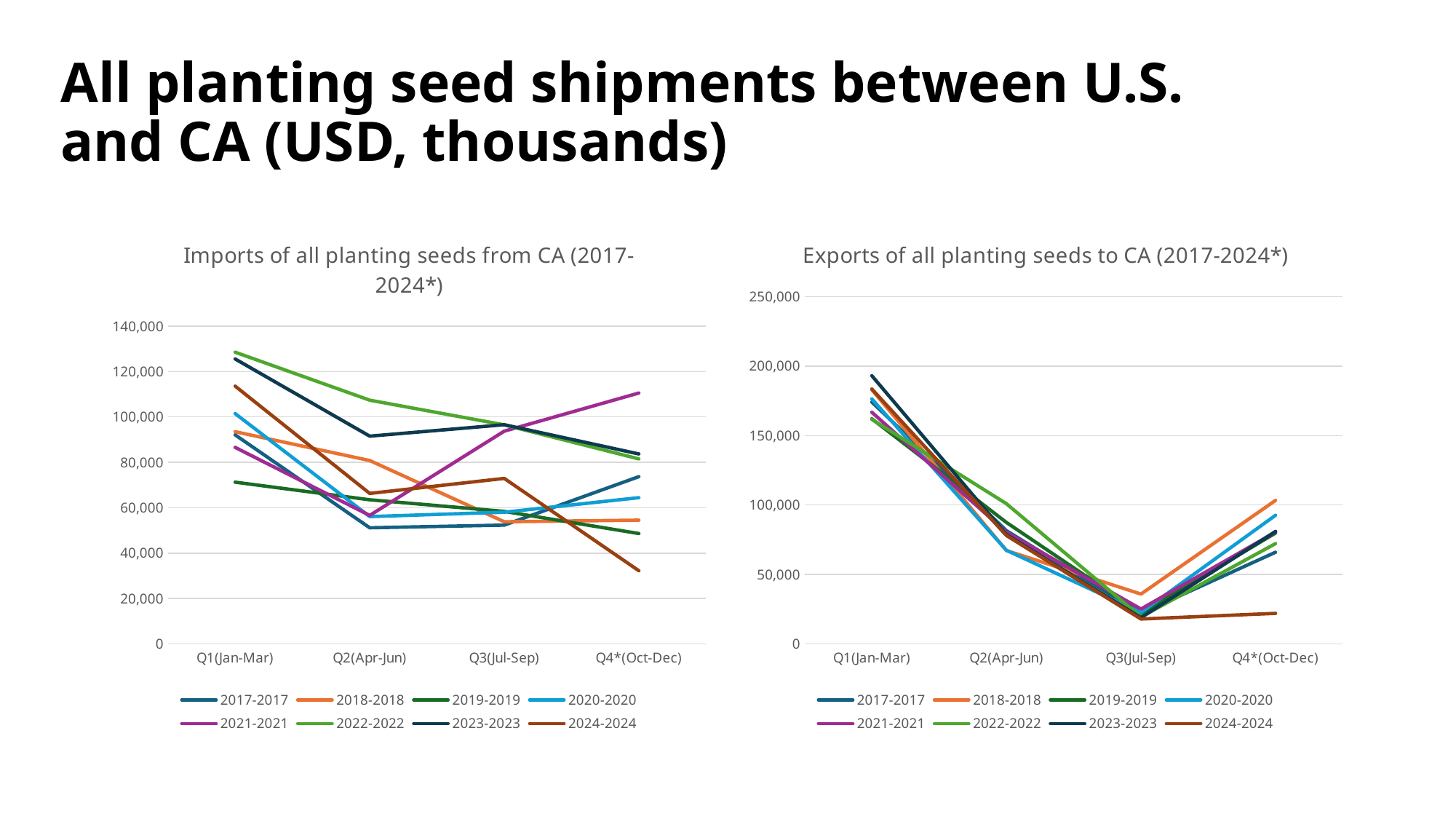
In the 'Imports of all planting seeds from CA (2017-2024*)' chart, is the 2022-2022 value for Q1(Jan-Mar) greater or less than 120,000? greater How many series does the legend of the 'Imports of all planting seeds from CA (2017-2024*)' chart list? 8 In the 'Exports of all planting seeds to CA (2017-2024*)' chart, do the values rise or fall from Q1(Jan-Mar) to Q3(Jul-Sep)? fall In the 'Exports of all planting seeds to CA (2017-2024*)' chart, is the 2024-2024 value for Q3(Jul-Sep) greater or less than 50,000? less In the 'Imports of all planting seeds from CA (2017-2024*)' chart, which is larger at Q1(Jan-Mar): 2022-2022 or 2019-2019? 2022-2022 In the 'Imports of all planting seeds from CA (2017-2024*)' chart, is the 2024-2024 value for Q4*(Oct-Dec) greater or less than 40,000? less In the 'Exports of all planting seeds to CA (2017-2024*)' chart, which is larger at Q4*(Oct-Dec): 2018-2018 or 2024-2024? 2018-2018 How many quarters are shown on the x axis of the 'Exports of all planting seeds to CA (2017-2024*)' chart? 4 What is the highest value shown on the y axis of the 'Exports of all planting seeds to CA (2017-2024*)' chart? 250,000 What kind of chart is the 'Imports of all planting seeds from CA (2017-2024*)' chart? line chart In the 'Imports of all planting seeds from CA (2017-2024*)' chart, does the 2022-2022 series rise or fall from Q1(Jan-Mar) to Q4*(Oct-Dec)? fall